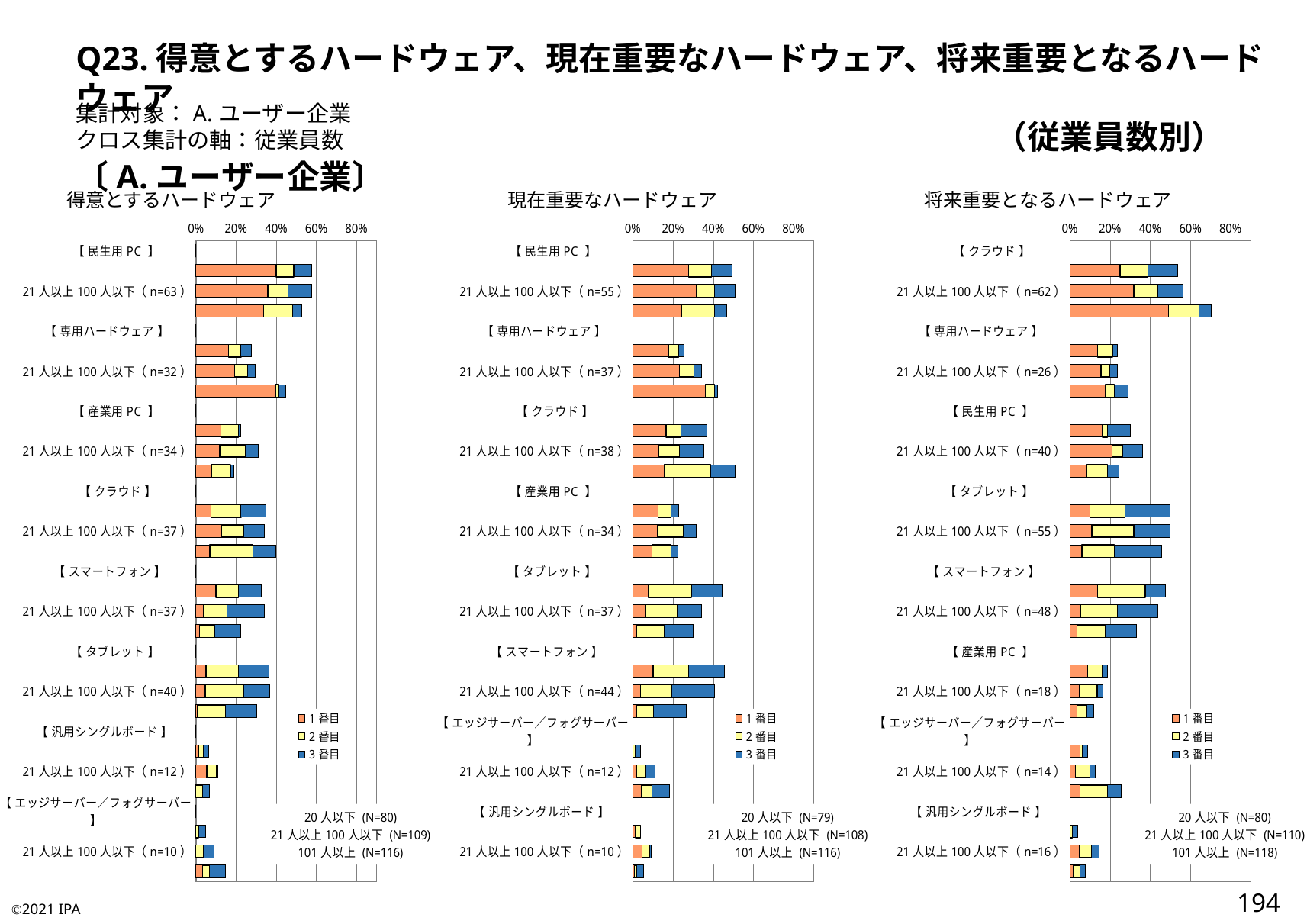
In the 得意とするハードウェア chart, is the total bar for 汎用シングルボード, 21人以上100人以下 (n=12) greater or less than 20%? less In the 将来重要となるハードウェア chart, is the total bar for クラウド, 21人以上100人以下 (n=62) greater or less than 40%? greater What are the legend entries of the 将来重要となるハードウェア chart? 1番目, 2番目, 3番目 How many hardware categories (bracketed headings) are shown in the 得意とするハードウェア chart? 8 In the 将来重要となるハードウェア chart, which hardware category is listed first (at the top)? クラウド How many series does the legend of the 現在重要なハードウェア chart list? 3 In the 得意とするハードウェア chart, is the total bar for 民生用PC, 21人以上100人以下 (n=63) greater or less than 40%? greater What kind of chart is used for 得意とするハードウェア on the left of the slide? stacked bar chart In the 将来重要となるハードウェア chart, which total bar is longer: クラウド 21人以上100人以下 (n=62) or 専用ハードウェア 21人以上100人以下 (n=26)? クラウド 21人以上100人以下 (n=62)